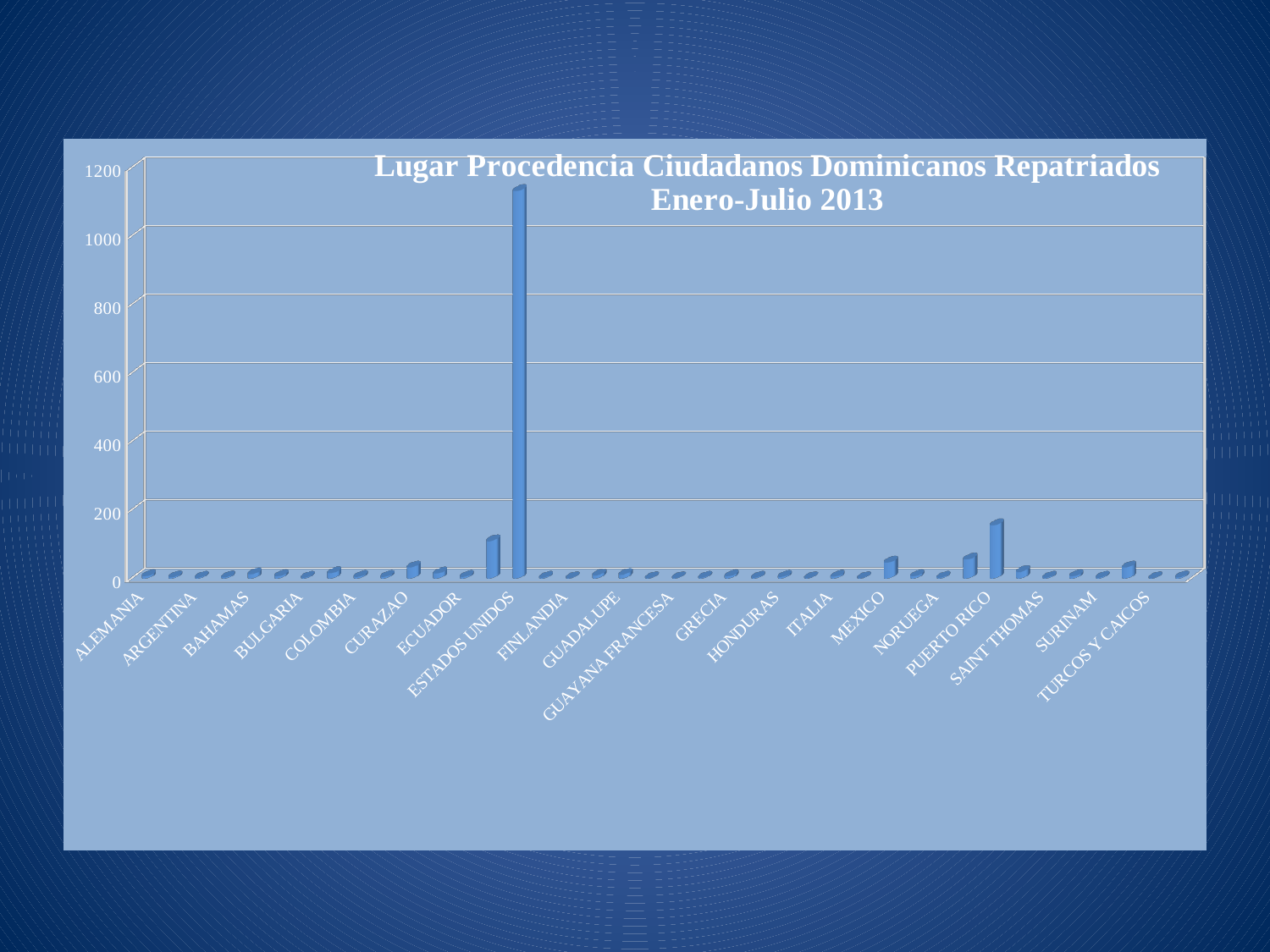
Is the value for ECUADOR greater or less than 400? less Is the value for MEXICO greater or less than 200? less What is the title of the chart? Lugar Procedencia Ciudadanos Dominicanos Repatriados Enero-Julio 2013 Which is larger, the value for PUERTO RICO or the value for MEXICO? PUERTO RICO What kind of chart is shown on the slide? bar chart Which category has the highest value in the chart? ESTADOS UNIDOS What is the highest value shown on the vertical axis? 1200 Is the value for ESTADOS UNIDOS greater or less than 1000? greater Which is larger, the value for ESTADOS UNIDOS or the value for PUERTO RICO? ESTADOS UNIDOS